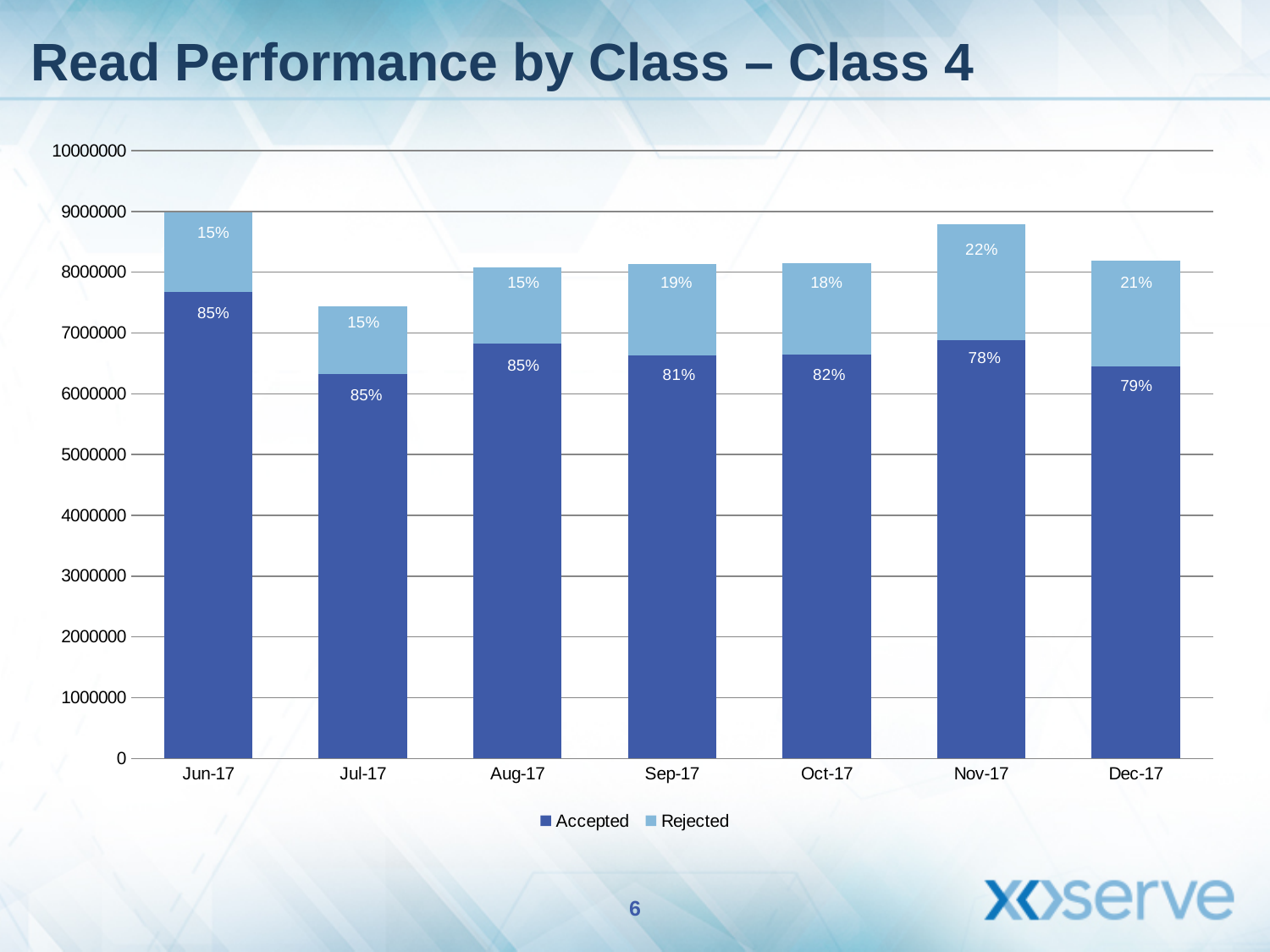
What is the Accepted percentage shown for Dec-17? 79% Which month has the larger Rejected percentage, Sep-17 or Oct-17? Sep-17 What kind of chart is shown on the slide? Stacked bar chart How many series does the legend list? 2 What percentage of Class 4 reads were Accepted in Jun-17? 85% How many months are shown on the x axis? 7 What percentage of Class 4 reads were Rejected in Nov-17? 22% Is the total height of the Nov-17 bar greater or less than 8000000? greater Which month has the highest Rejected percentage? Nov-17 Which month has the lowest Accepted percentage? Nov-17 By how many percentage points does the Rejected share in Nov-17 exceed the Rejected share in Jun-17? 7 percentage points Is the total height of the Jul-17 bar greater or less than 8000000? less